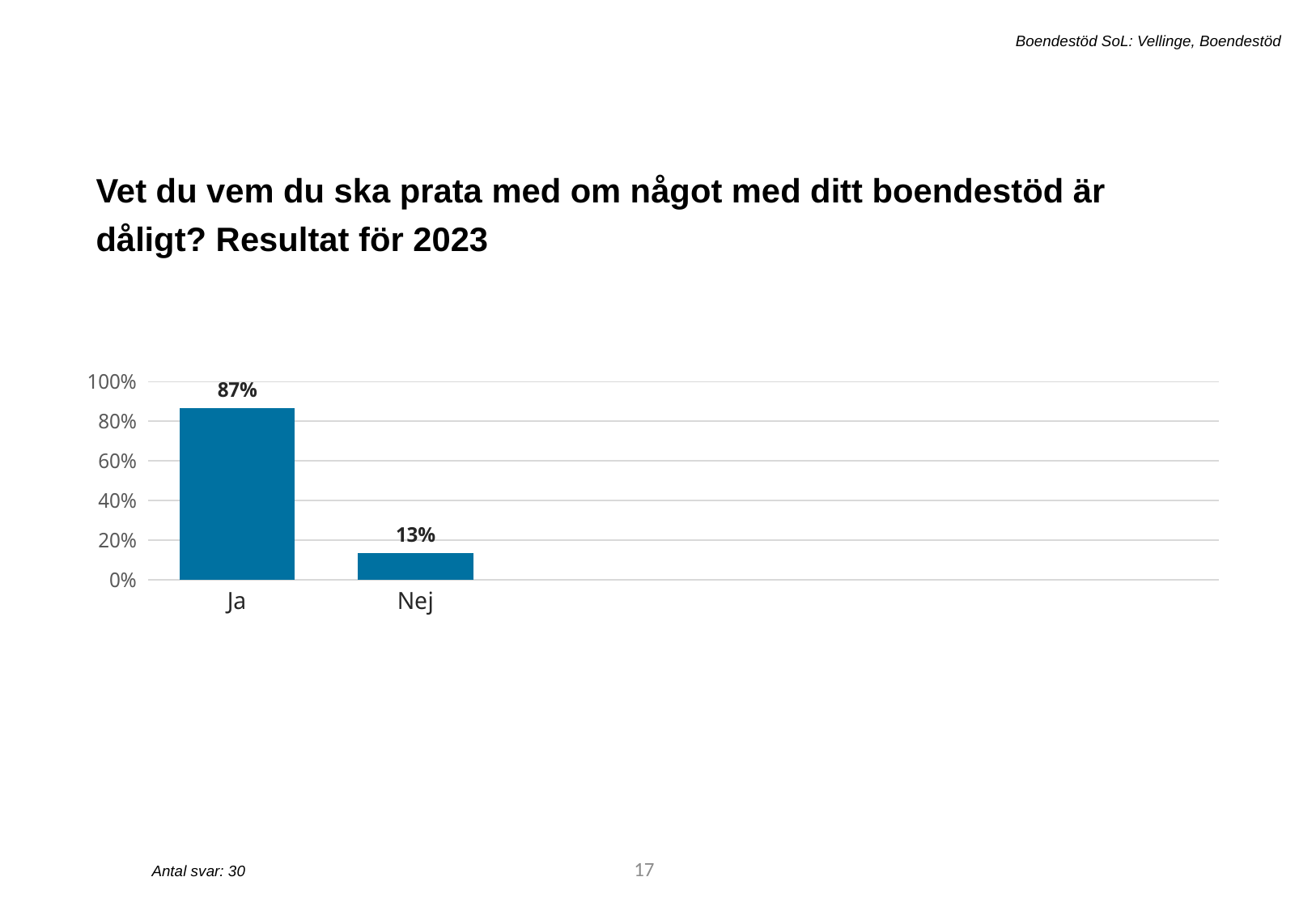
What is the highest value shown on the y axis? 100% Which category has the lowest value? Nej What is the value for Nej? 13% Is the value for Ja greater or less than 80%? greater What kind of chart is shown on the slide? bar chart Which is larger, the value for Ja or the value for Nej? Ja How many categories are shown on the x axis? 2 What is the difference between the values for Ja and Nej? 74% What is the value for Ja? 87% Which category has the highest value? Ja Is the value for Nej greater or less than 20%? less How many responses (Antal svar) does the slide report? 30